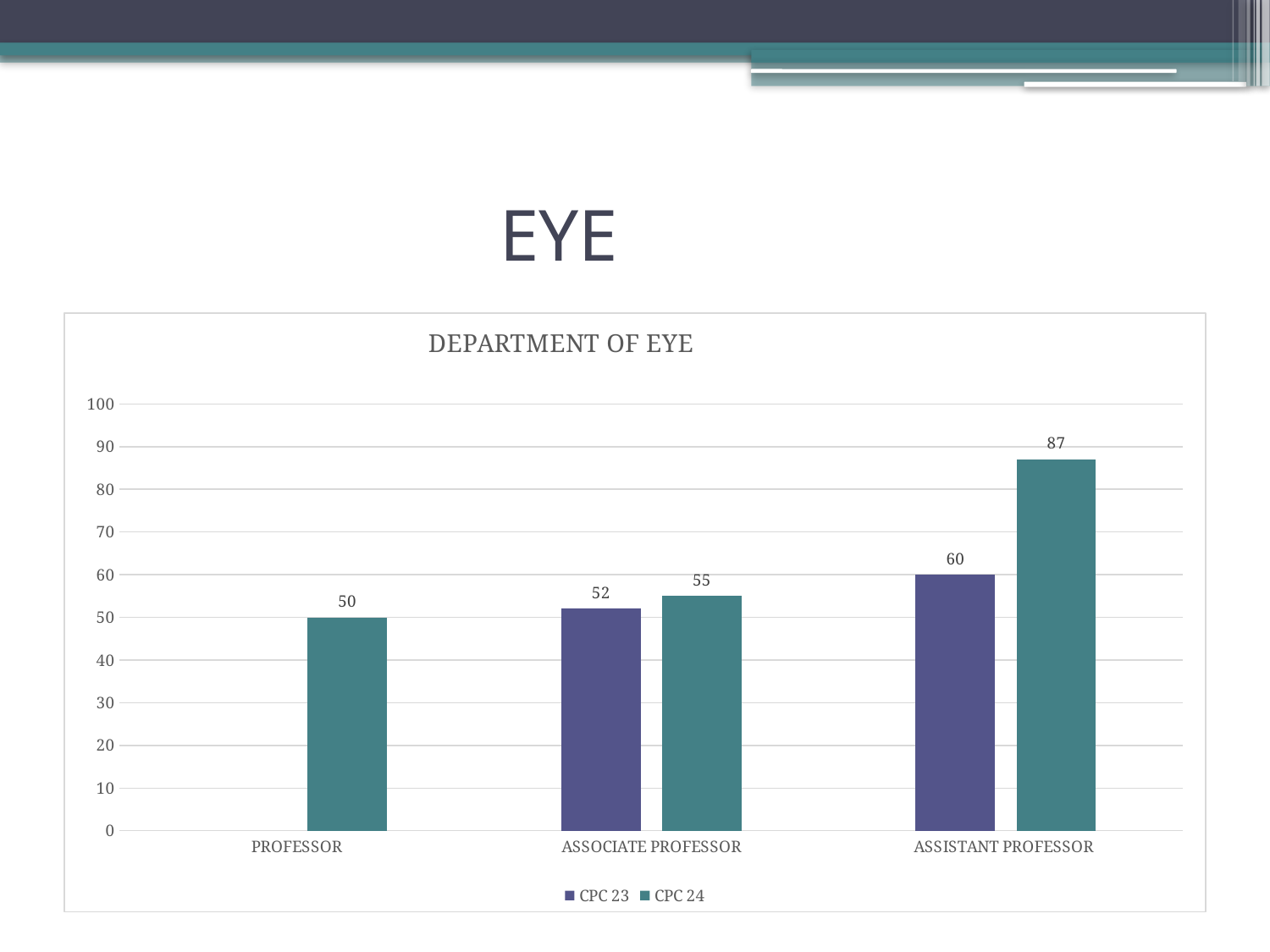
Which category has the lowest CPC 24 value? PROFESSOR How many categories are shown on the x axis? 3 What is the CPC 24 value for PROFESSOR? 50 Which is larger for ASSOCIATE PROFESSOR, CPC 23 or CPC 24? CPC 24 How many series does the legend list? 2 What is the difference between the CPC 24 and CPC 23 values for ASSISTANT PROFESSOR? 27 Which category has the highest CPC 24 value? ASSISTANT PROFESSOR What is the title of the chart? DEPARTMENT OF EYE What is the CPC 23 value for ASSOCIATE PROFESSOR? 52 What kind of chart is shown on the slide? Bar chart What is the CPC 24 value for ASSISTANT PROFESSOR? 87 What is the CPC 23 value for ASSISTANT PROFESSOR? 60